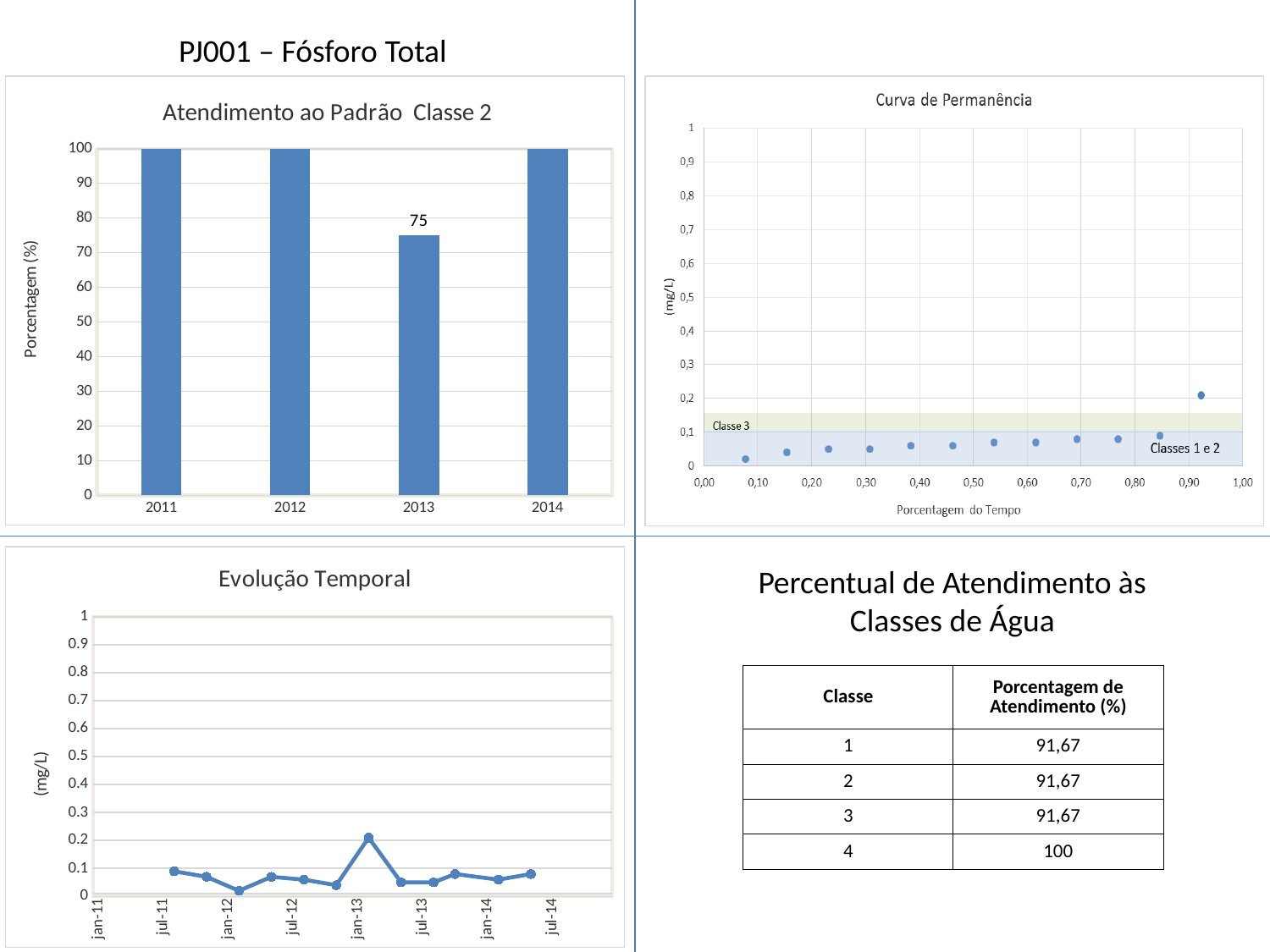
What kind of chart is the 'Atendimento ao Padrão Classe 2' chart? bar chart How many years are shown in the 'Atendimento ao Padrão Classe 2' chart? 4 What kind of chart is the 'Evolução Temporal' chart? line chart In the 'Atendimento ao Padrão Classe 2' chart, what is the difference between the values for 2012 and 2013? 25 What is the x-axis title of the 'Curva de Permanência' chart? Porcentagem do Tempo In the 'Atendimento ao Padrão Classe 2' chart, which is larger, the value for 2013 or the value for 2014? 2014 In the 'Atendimento ao Padrão Classe 2' chart, which year has the lowest value? 2013 How many data points are plotted in the 'Curva de Permanência' chart? 12 In the 'Atendimento ao Padrão Classe 2' chart, is the value for 2013 greater or less than 80? less In the 'Evolução Temporal' chart, is the highest point (near jan-13) greater or less than 0.1? greater In the 'Atendimento ao Padrão Classe 2' chart, what is the value for 2013? 75 In the 'Atendimento ao Padrão Classe 2' chart, what is the value for 2011? 100